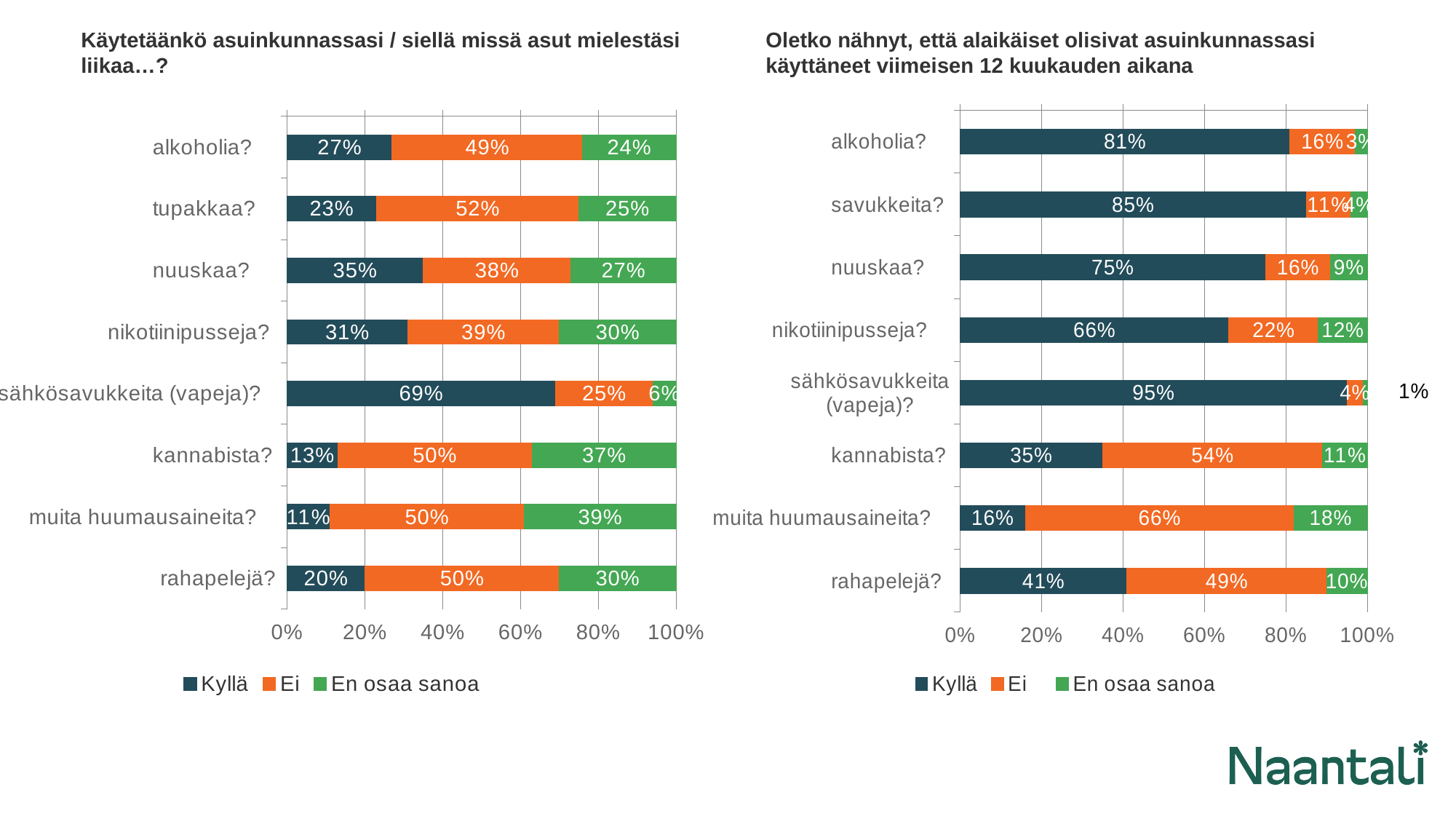
In the right chart, what is the En osaa sanoa value for muita huumausaineita? 18% In the right chart, which category has the highest Kyllä value? sähkösavukkeita (vapeja)? In the right chart, what is the Kyllä value for nuuskaa? 75% How many categories does the left chart show? 8 In the right chart, what is the Ei value for rahapelejä? 49% How many series does the legend of the right chart list? 3 In the left chart, what is the Kyllä value for sähkösavukkeita (vapeja)? 69% In the left chart, what is the Ei value for tupakkaa? 52% What type of chart is the left chart? Stacked bar chart In the left chart, which is larger: the Kyllä value for nuuskaa or the Kyllä value for nikotiinipusseja? nuuskaa In the right chart, what is the difference between the Kyllä values for savukkeita and kannabista? 50% In the left chart, which category has the lowest Kyllä value? muita huumausaineita?